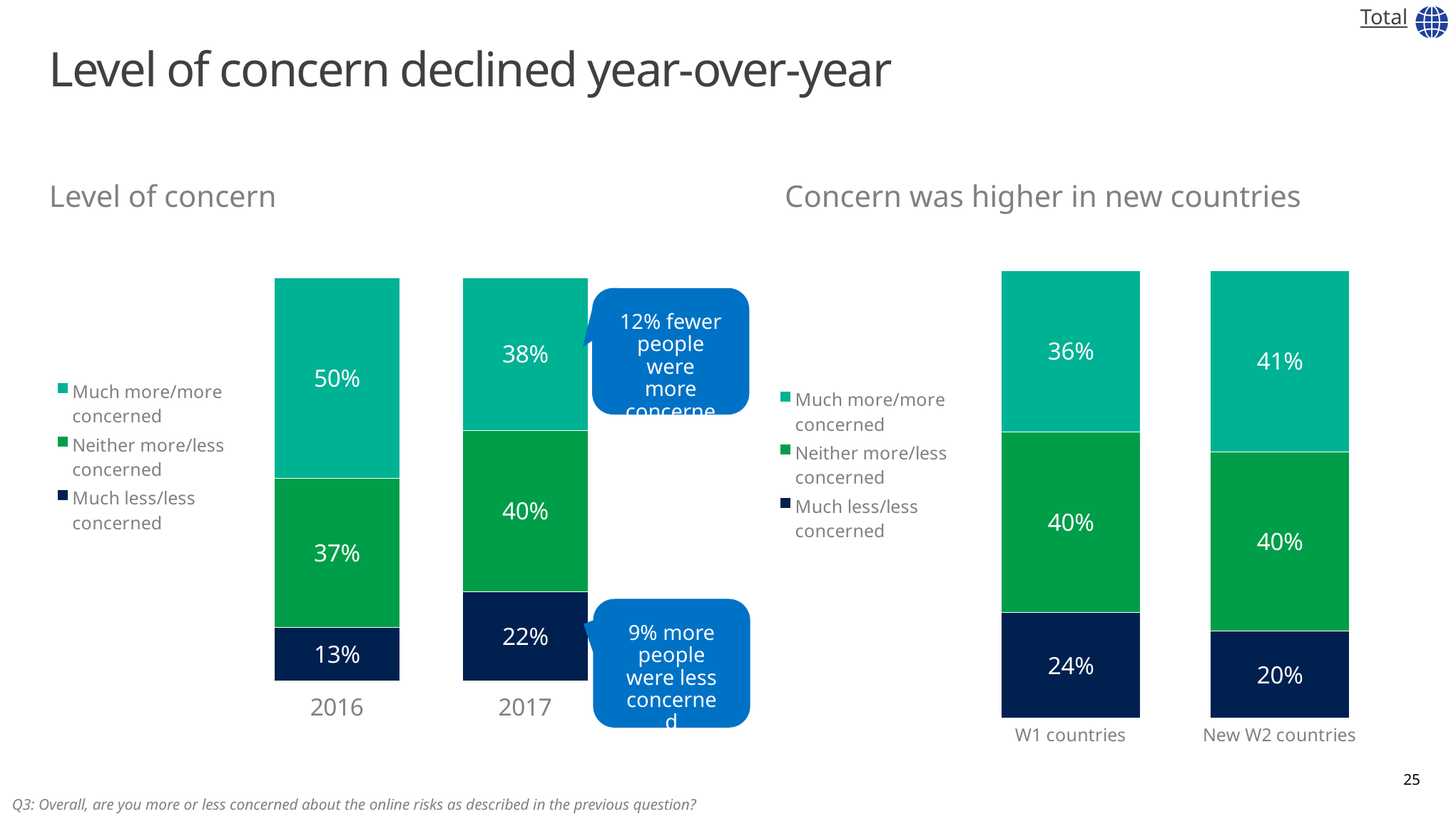
How many series does the legend of the 'Concern was higher in new countries' chart list? 3 In the 'Concern was higher in new countries' chart, what percentage of W1 countries were much less/less concerned? 24% How many categories are shown on the x axis of the 'Level of concern' chart? 2 In the 'Concern was higher in new countries' chart, which group had the higher share of much more/more concerned respondents, W1 countries or New W2 countries? New W2 countries In the 'Level of concern' chart, what percentage were much less/less concerned in 2017? 22% In the 'Level of concern' chart, by how many percentage points did the much more/more concerned share fall from 2016 to 2017? 12 percentage points In the 'Level of concern' chart, what is the total of the stacked bar for 2016? 100% In the 'Concern was higher in new countries' chart, what is the difference in the much less/less concerned share between W1 countries and New W2 countries? 4 percentage points In the 'Concern was higher in new countries' chart, what percentage of New W2 countries were much more/more concerned? 41% In the 'Level of concern' chart, which year had the larger share of much less/less concerned respondents, 2016 or 2017? 2017 What type of chart is the 'Level of concern' chart? Stacked bar chart In the 'Level of concern' chart, what percentage were much more/more concerned in 2016? 50%